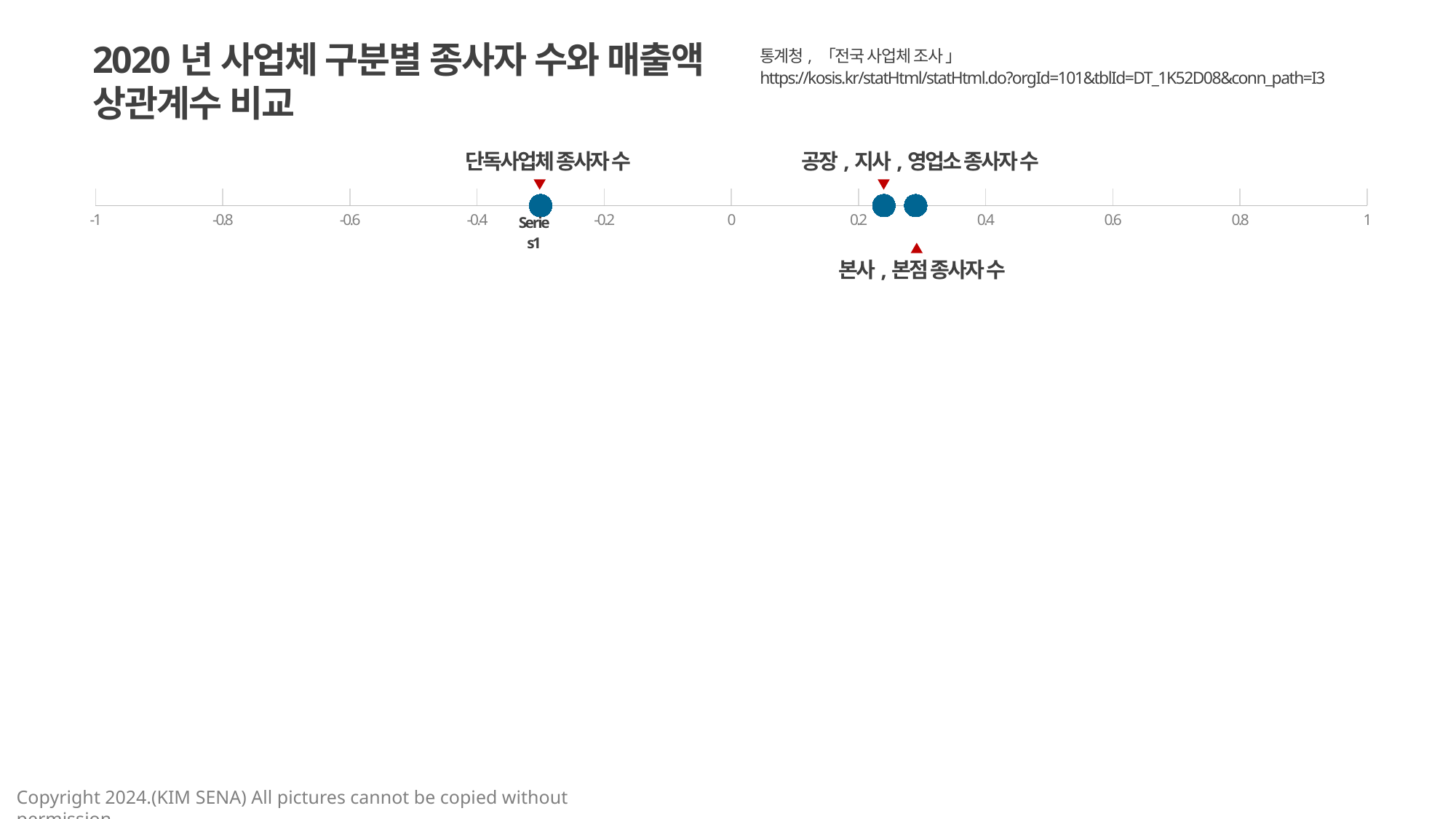
Is the value for 단독사업체 종사자 수 greater or less than 0? less What is the title of the chart on the slide? 2020년 사업체 구분별 종사자 수와 매출액 상관계수 비교 Is the value for 본사, 본점 종사자 수 greater or less than 0.4? less Which category has the lowest correlation coefficient on the chart? 단독사업체 종사자 수 Is the value for 공장, 지사, 영업소 종사자 수 greater or less than 0? greater What kind of chart is shown on the slide? scatter chart (dot plot) Which is larger, the value for 단독사업체 종사자 수 or the value for 본사, 본점 종사자 수? 본사, 본점 종사자 수 Which category has the highest correlation coefficient on the chart? 본사, 본점 종사자 수 What are the minimum and maximum values shown on the chart's axis? -1 and 1 How many data points are plotted on the chart? 3